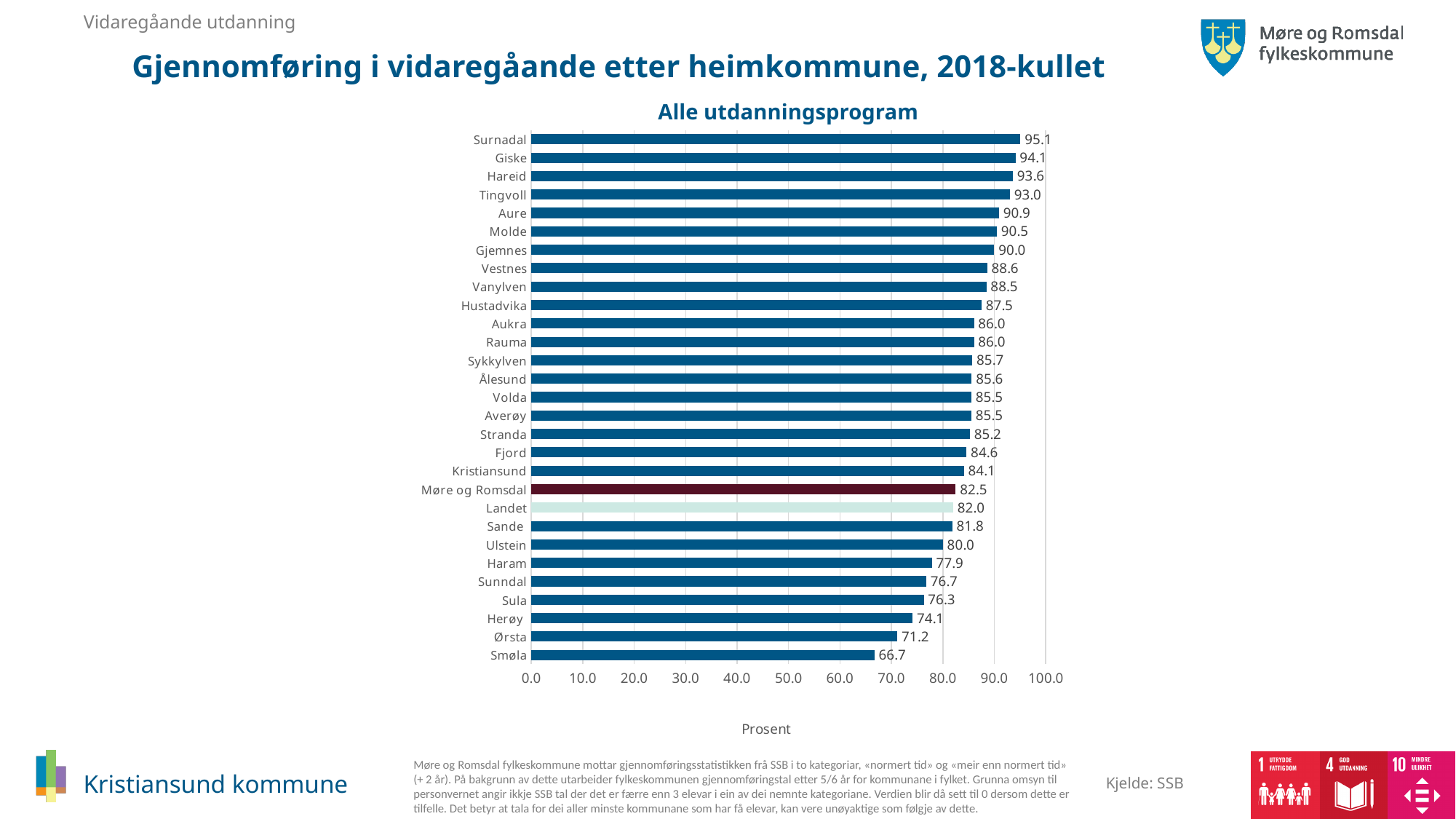
Which category has the highest value? Surnadal What is the title of the chart? Alle utdanningsprogram How many categories are shown in the chart? 29 Is the value for Ørsta greater or less than 80.0? less What is the value for Landet? 82.0 Which category has the lowest value? Smøla What is the difference between the values for Surnadal and Smøla? 28.4 What is the value for Møre og Romsdal? 82.5 Which is larger, the value for Molde or the value for Ålesund? Molde What is the value for Kristiansund? 84.1 What kind of chart is shown on the slide? bar chart What is the difference between the values for Kristiansund and Landet? 2.1